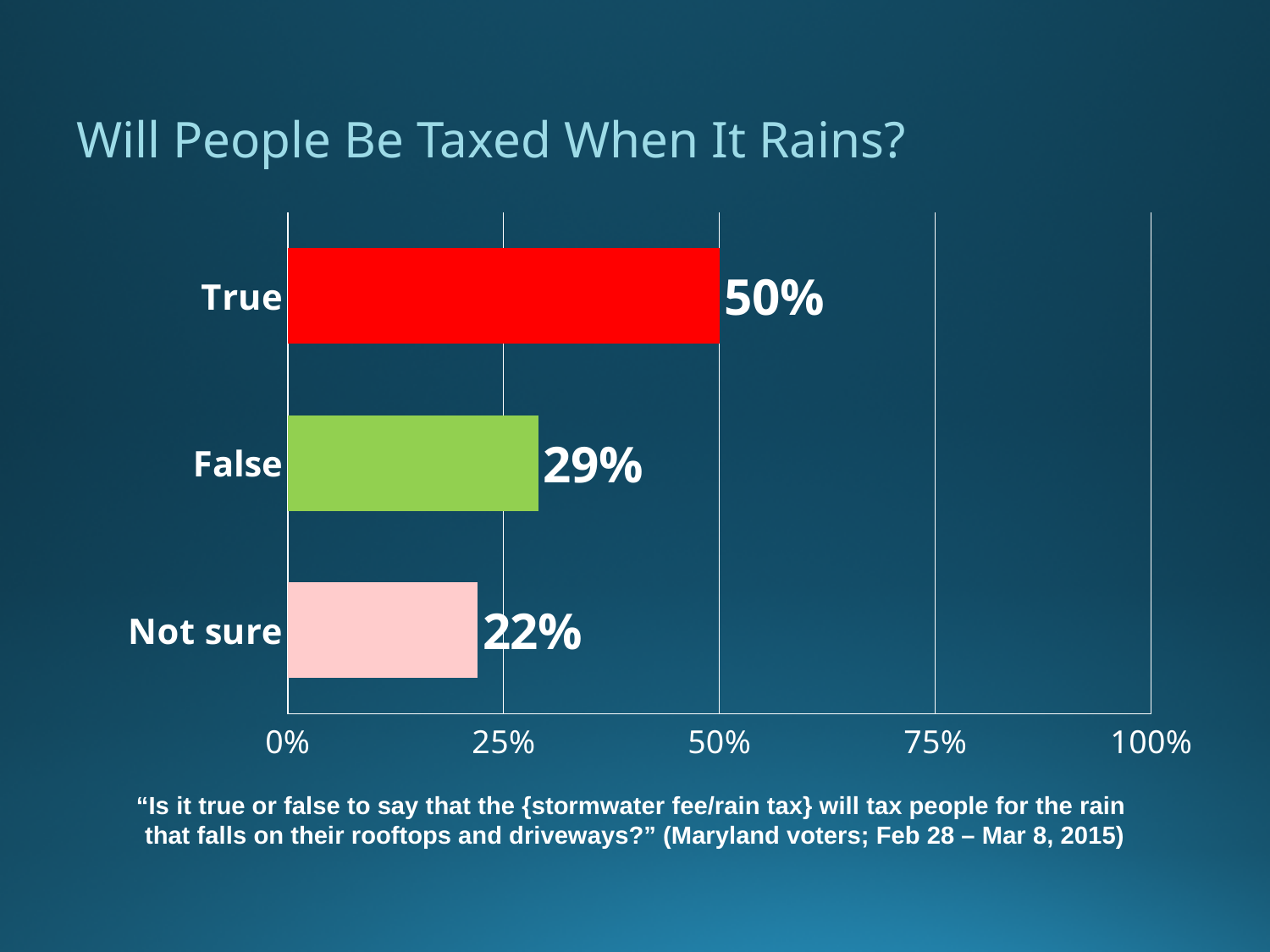
Which response category has the lowest value? Not sure What is the difference between the "False" and "Not sure" percentages? 7% What is the difference between the "True" and "False" percentages? 21% Which is larger, the value for "False" or the value for "Not sure"? False What percentage of respondents answered "False"? 29% Which response category has the highest value? True What percentage of respondents answered "Not sure"? 22% Is the value for "False" greater or less than 25%? greater What is the title of the slide? Will People Be Taxed When It Rains? How many response categories are shown in the chart? 3 What kind of chart is shown on the slide? Bar chart What percentage of respondents answered "True"? 50%